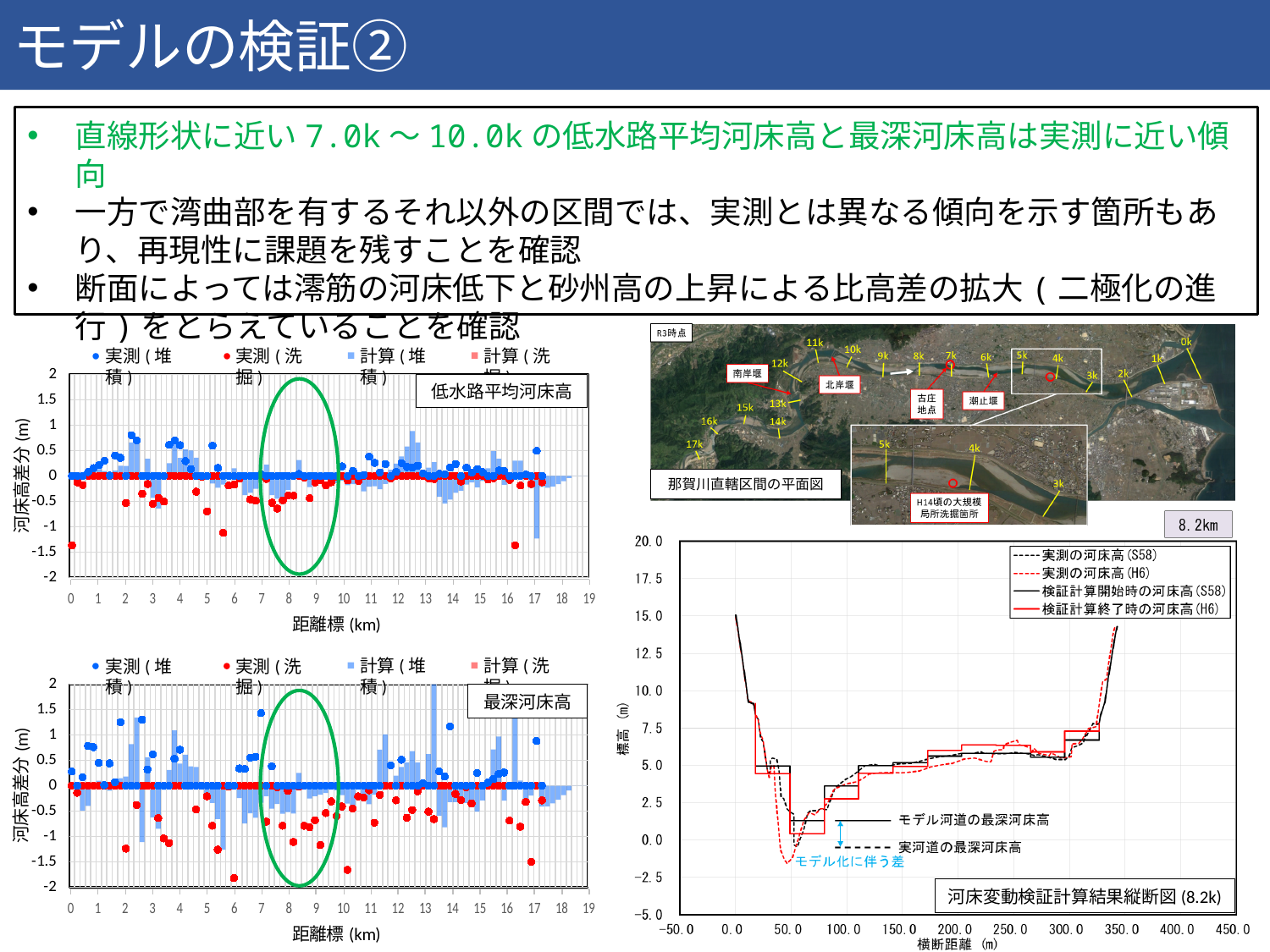
How many series does the legend of the 河床変動検証計算結果縦断図 (8.2k) chart list? 4 What is the y-axis label of the 河床変動検証計算結果縦断図 (8.2k) chart? 標高 (m) In the 河床変動検証計算結果縦断図 (8.2k) chart, do the values fall or rise between 0.0 m and 50.0 m on the x axis? fall In the 河床変動検証計算結果縦断図 (8.2k) chart, is the lowest value of 実測の河床高(H6) greater or less than 0.0? less In the 河床変動検証計算結果縦断図 (8.2k) chart, is the value of 実測の河床高(H6) at 300.0 m greater or less than 5.0? greater In the top-left 低水路平均河床高 chart, is the 実測(洗掘) value near 16.5 km greater or less than -1? less What is the x-axis label of the two charts on the left of the slide? 距離標 (km) How many series does the legend of the top-left 低水路平均河床高 chart list? 4 What kind of chart is the 河床変動検証計算結果縦断図 (8.2k) chart on the right of the slide? line chart